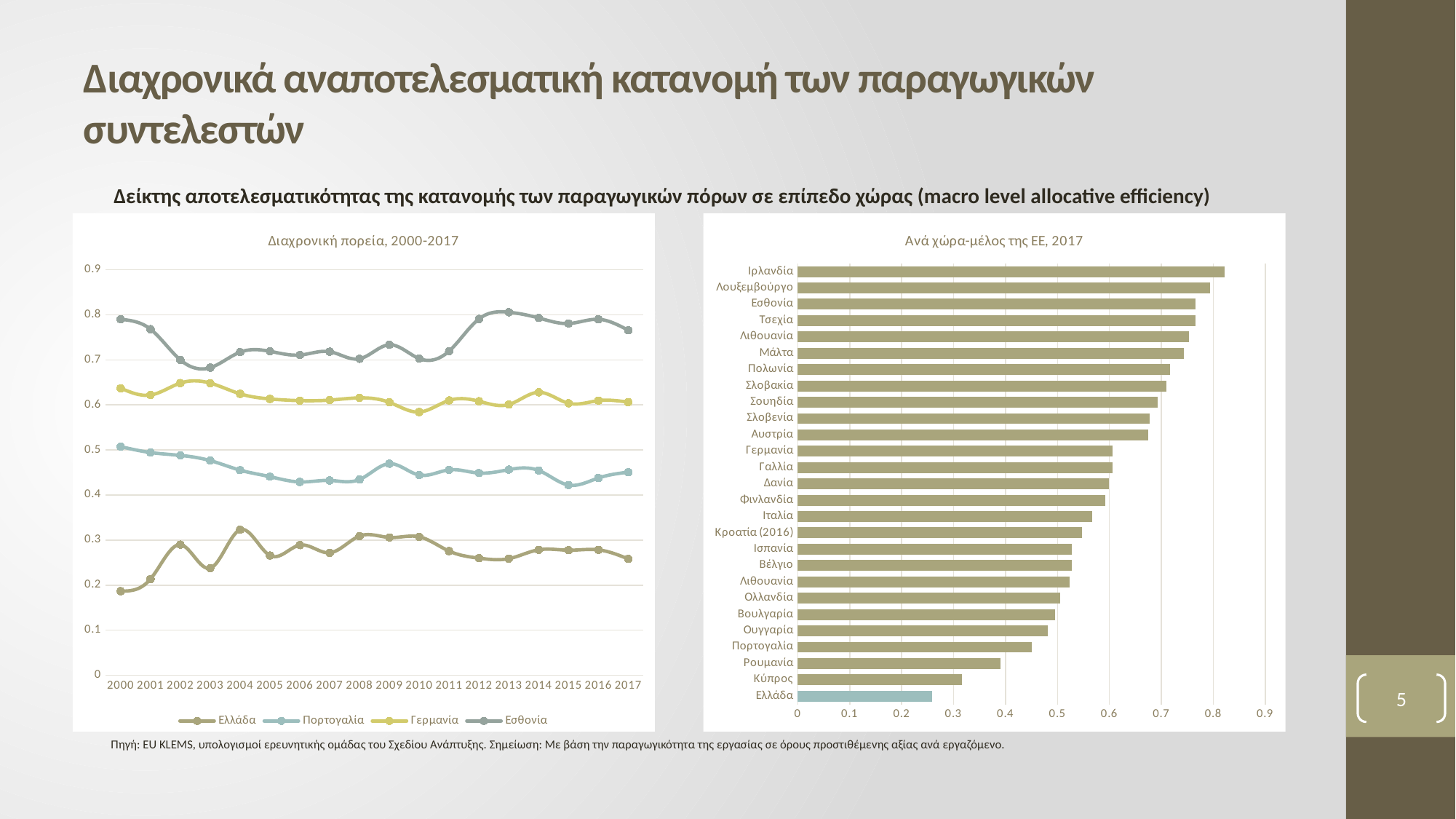
In the chart 'Ανά χώρα-μέλος της ΕΕ, 2017', which country has the lowest value? Ελλάδα How many years are plotted on the x axis of the chart 'Διαχρονική πορεία, 2000-2017'? 18 In the chart 'Διαχρονική πορεία, 2000-2017', which series has the highest value in 2017? Εσθονία In the chart 'Ανά χώρα-μέλος της ΕΕ, 2017', is the value for Σουηδία greater or less than 0.6? greater In the chart 'Ανά χώρα-μέλος της ΕΕ, 2017', is the value for Πορτογαλία greater or less than 0.5? less In the chart 'Διαχρονική πορεία, 2000-2017', does the Πορτογαλία series rise or fall from 2000 to 2017? fall In the chart 'Διαχρονική πορεία, 2000-2017', is the value for Ελλάδα in 2000 greater or less than 0.2? less In the chart 'Ανά χώρα-μέλος της ΕΕ, 2017', which country has the highest value? Ιρλανδία How many countries are shown in the chart 'Ανά χώρα-μέλος της ΕΕ, 2017'? 27 What kind of chart is the right-hand chart titled 'Ανά χώρα-μέλος της ΕΕ, 2017'? bar chart How many series does the legend of the chart 'Διαχρονική πορεία, 2000-2017' list? 4 In the chart 'Ανά χώρα-μέλος της ΕΕ, 2017', which is larger, the value for Μάλτα or the value for Ιταλία? Μάλτα